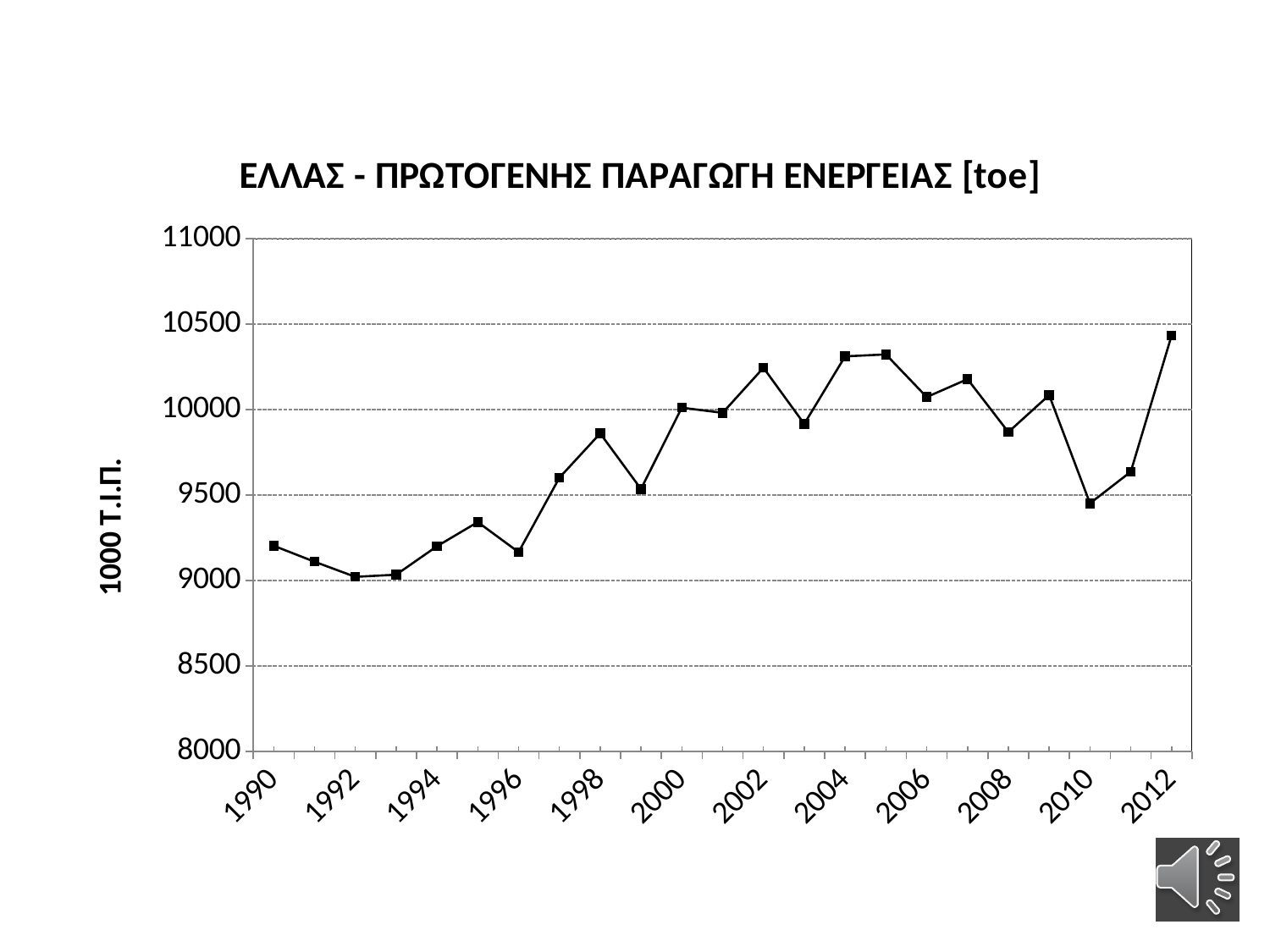
Which year has the larger value, 2009 or 2010? 2009 What is the title of the chart? ΕΛΛΑΣ - ΠΡΩΤΟΓΕΝΗΣ ΠΑΡΑΓΩΓΗ ΕΝΕΡΓΕΙΑΣ [toe] What kind of chart is shown on the slide? line chart What is the label on the vertical axis? 1000 Τ.Ι.Π. Is the value for 1998 greater or less than 10000? less Which year has the highest value on the chart? 2012 Is the value for 2012 greater or less than 10000? greater Is the value for 2002 greater or less than 10000? greater Overall, do the values rise or fall from 1990 to 2012? rise How many data points are plotted on the line? 23 Which year has the larger value, 1990 or 2012? 2012